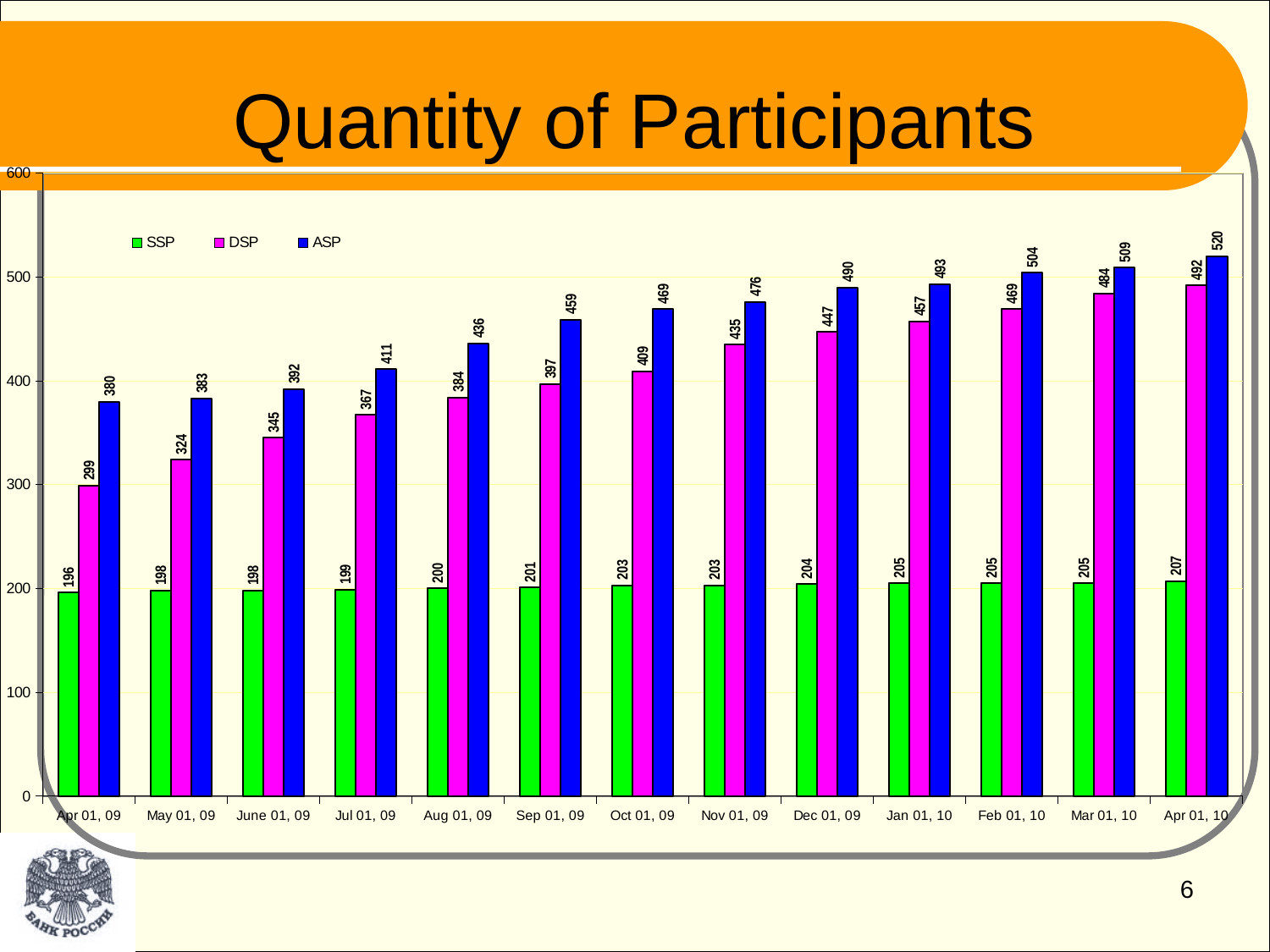
What kind of chart is shown on the slide? Bar chart Do the ASP values rise or fall from Apr 01, 09 to Apr 01, 10? Rise What is the ASP value for Apr 01, 10? 520 Which date has the highest ASP value? Apr 01, 10 How many dates are shown on the x axis? 13 What is the DSP value for Jul 01, 09? 367 What is the difference between the ASP and DSP values for Dec 01, 09? 43 Is the DSP value for Nov 01, 09 greater or less than 400? greater What is the SSP value for Apr 01, 09? 196 Which date has the lowest DSP value? Apr 01, 09 How many series does the legend list? 3 Which is larger, the DSP value for Sep 01, 09 or the ASP value for June 01, 09? DSP value for Sep 01, 09